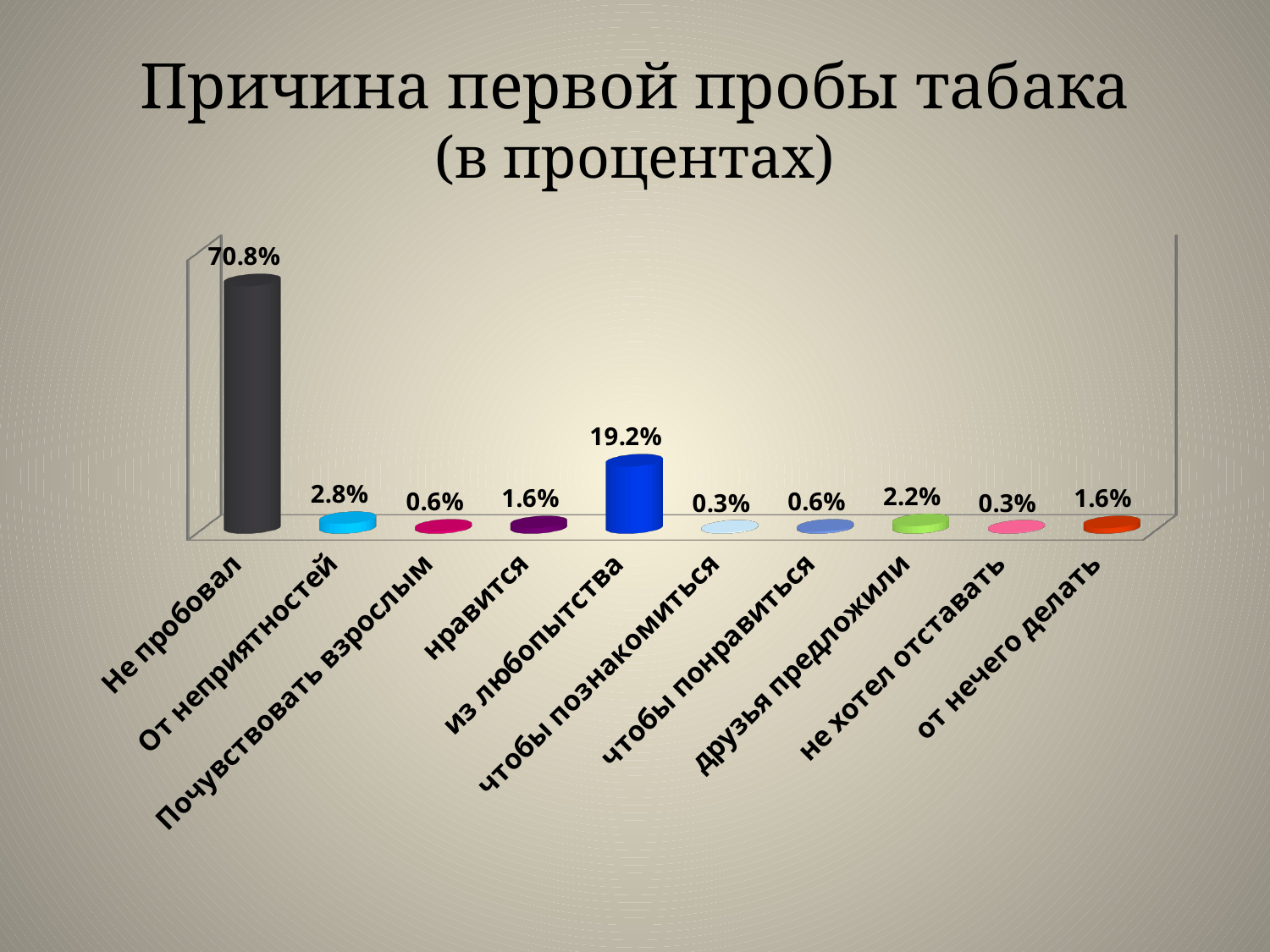
What is the value for "От неприятностей"? 2.8% What is the value for "из любопытства"? 19.2% What is the value for "друзья предложили"? 2.2% What is the title of the slide? Причина первой пробы табака (в процентах) How many categories are shown on the chart? 10 Which category has the highest value? Не пробовал Which is larger, the value for "нравится" or the value for "чтобы познакомиться"? нравится What is the value for "не хотел отставать"? 0.3% What is the value for "Не пробовал"? 70.8% What is the difference between the values for "Не пробовал" and "из любопытства"? 51.6% What kind of chart is shown on the slide? Bar chart What is the difference between the values for "От неприятностей" and "друзья предложили"? 0.6%